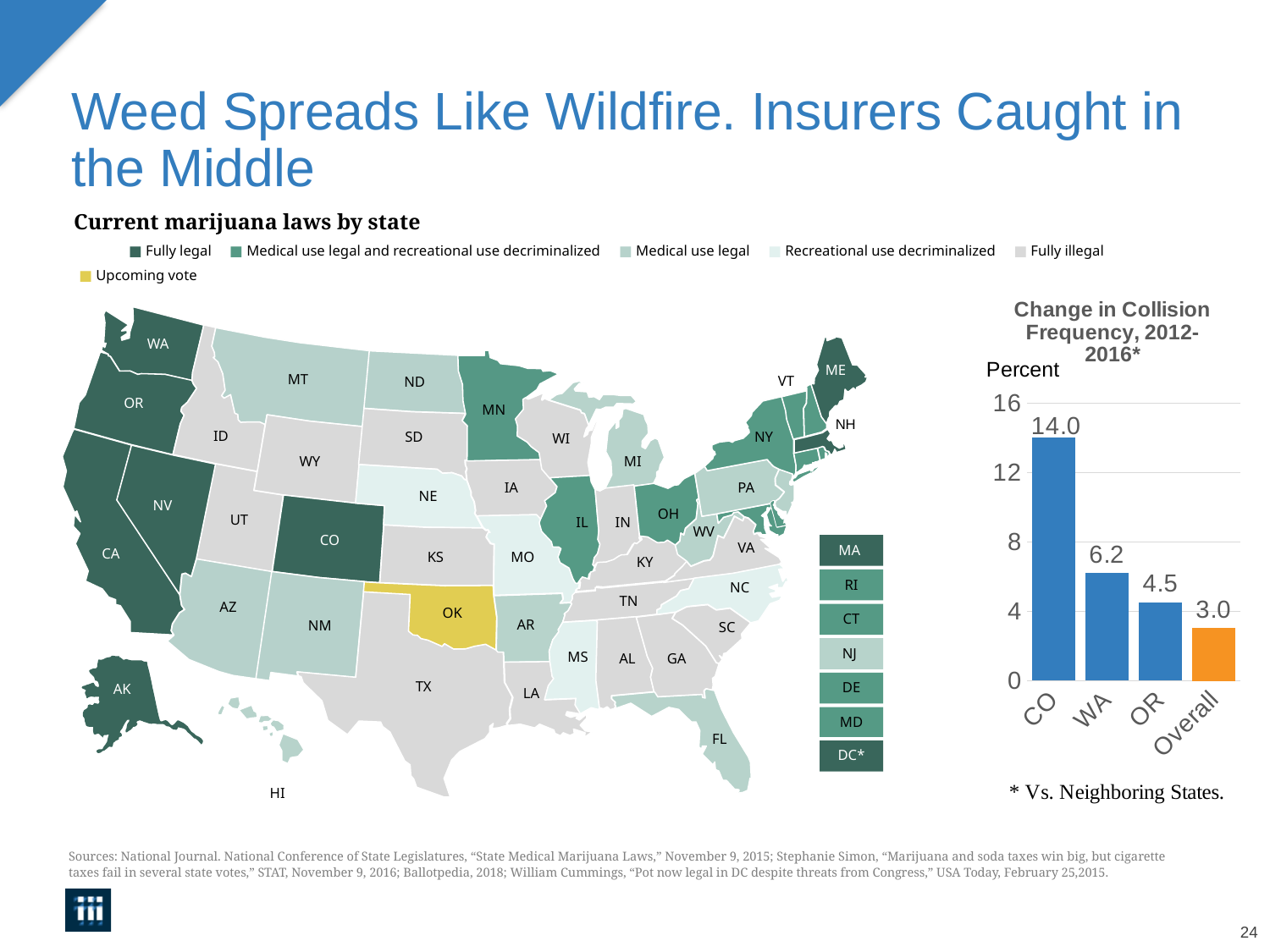
In the 'Change in Collision Frequency, 2012-2016*' chart, what is the value for WA? 6.2 In the 'Change in Collision Frequency, 2012-2016*' chart, which is larger, the value for WA or the value for OR? WA In the 'Change in Collision Frequency, 2012-2016*' chart, what is the value for OR? 4.5 In the 'Change in Collision Frequency, 2012-2016*' chart, is the value for CO greater or less than 12? greater In the 'Change in Collision Frequency, 2012-2016*' chart, which category has the lowest value? Overall What kind of chart is the 'Change in Collision Frequency, 2012-2016*' chart? bar chart In the 'Change in Collision Frequency, 2012-2016*' chart, what is the value for Overall? 3.0 In the 'Change in Collision Frequency, 2012-2016*' chart, which category has the highest value? CO In the 'Change in Collision Frequency, 2012-2016*' chart, what is the value for CO? 14.0 How many categories are shown in the 'Change in Collision Frequency, 2012-2016*' chart? 4 In the 'Change in Collision Frequency, 2012-2016*' chart, what unit is shown on the vertical axis label? Percent In the 'Change in Collision Frequency, 2012-2016*' chart, what is the difference between the values for CO and WA? 7.8